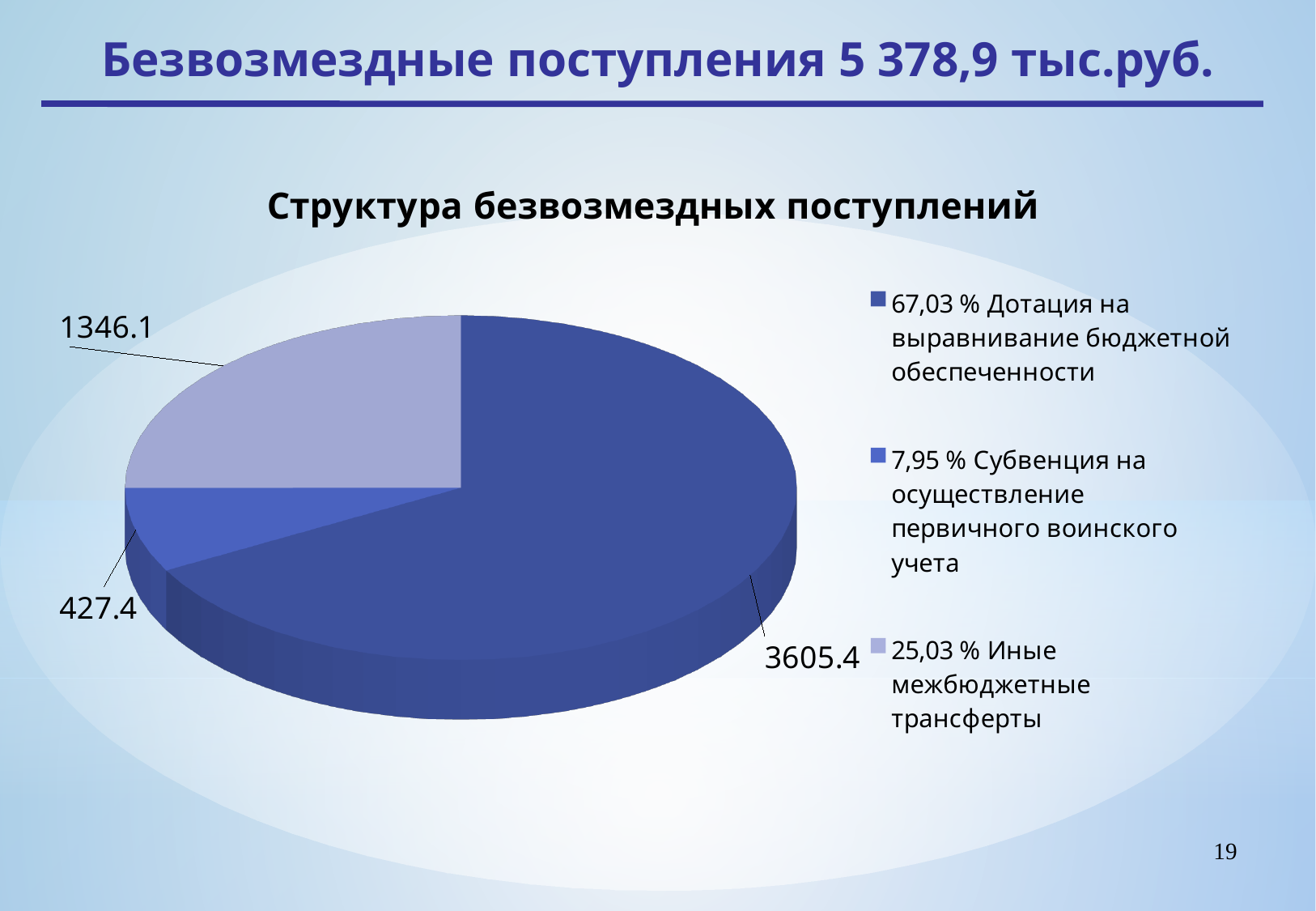
What is the value of the slice for Дотация на выравнивание бюджетной обеспеченности? 3605.4 What is the title of the chart? Структура безвозмездных поступлений What share of the pie does Иные межбюджетные трансферты represent, according to the legend? 25,03 % How many slices does the pie chart have? 3 What type of chart is shown on the slide? Pie chart Which is larger: the value for Иные межбюджетные трансферты or the value for Субвенция на осуществление первичного воинского учета? Иные межбюджетные трансферты Which category has the smallest slice of the pie? Субвенция на осуществление первичного воинского учета What is the difference between the values for Дотация на выравнивание бюджетной обеспеченности and Иные межбюджетные трансферты? 2259.3 What share of the pie does Субвенция на осуществление первичного воинского учета represent, according to the legend? 7,95 % What is the value of the slice for Иные межбюджетные трансферты? 1346.1 What is the value of the slice for Субвенция на осуществление первичного воинского учета? 427.4 Which category has the largest slice of the pie? Дотация на выравнивание бюджетной обеспеченности